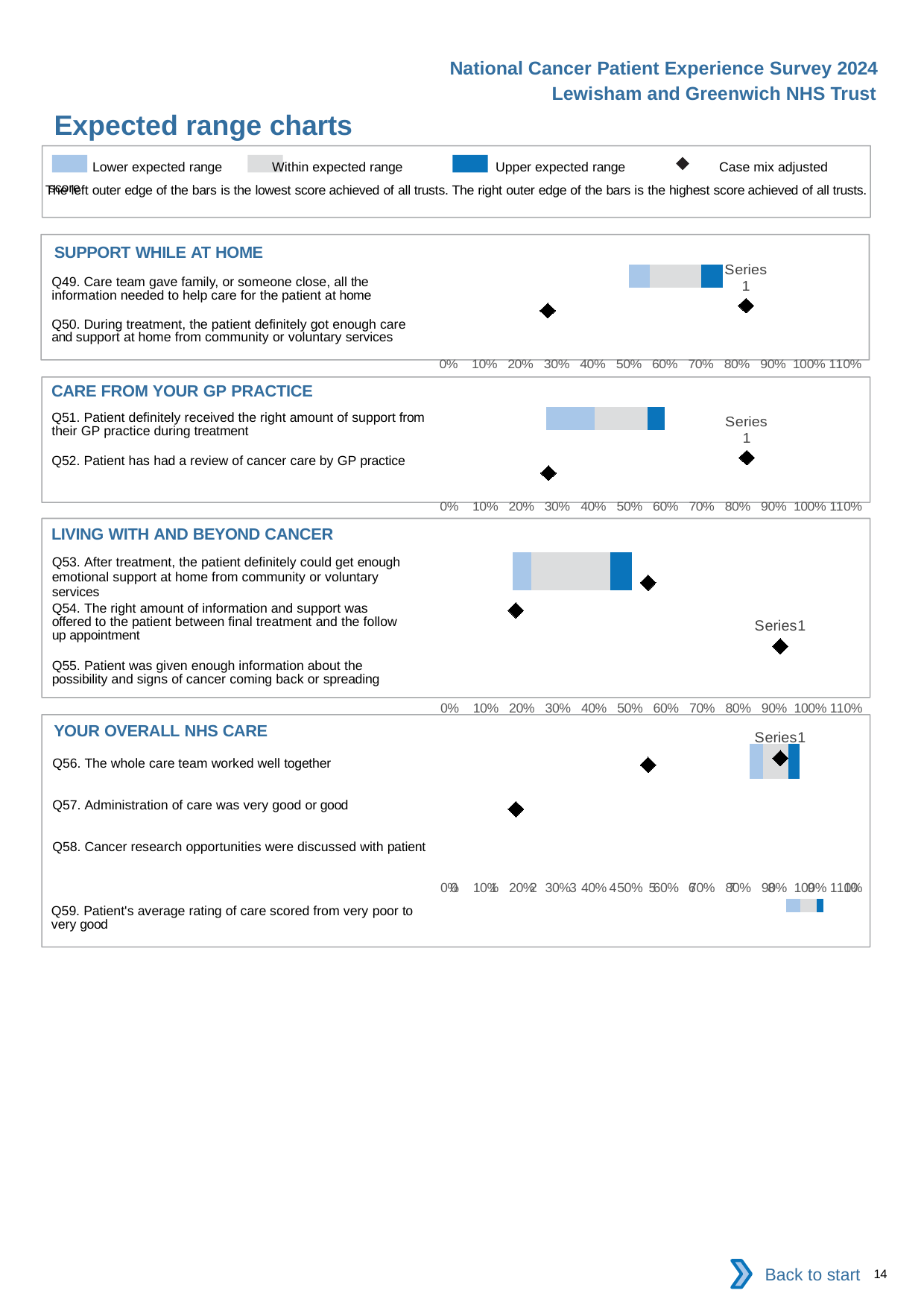
In the LIVING WITH AND BEYOND CANCER chart, is the right edge of the expected range bar greater or less than 60%? less How many questions are listed in the SUPPORT WHILE AT HOME chart? 2 How many questions are listed in the LIVING WITH AND BEYOND CANCER chart? 3 How many questions are listed in the YOUR OVERALL NHS CARE chart? 4 According to the legend, what does the diamond marker represent? Case mix adjusted score In the CARE FROM YOUR GP PRACTICE chart, is the leftmost diamond marker greater or less than 40%? less In the SUPPORT WHILE AT HOME chart, is the left edge of the expected range bar greater or less than 40%? greater What is the title of the slide containing the charts? Expected range charts In the SUPPORT WHILE AT HOME chart, what is the highest tick label shown on the x axis? 110%